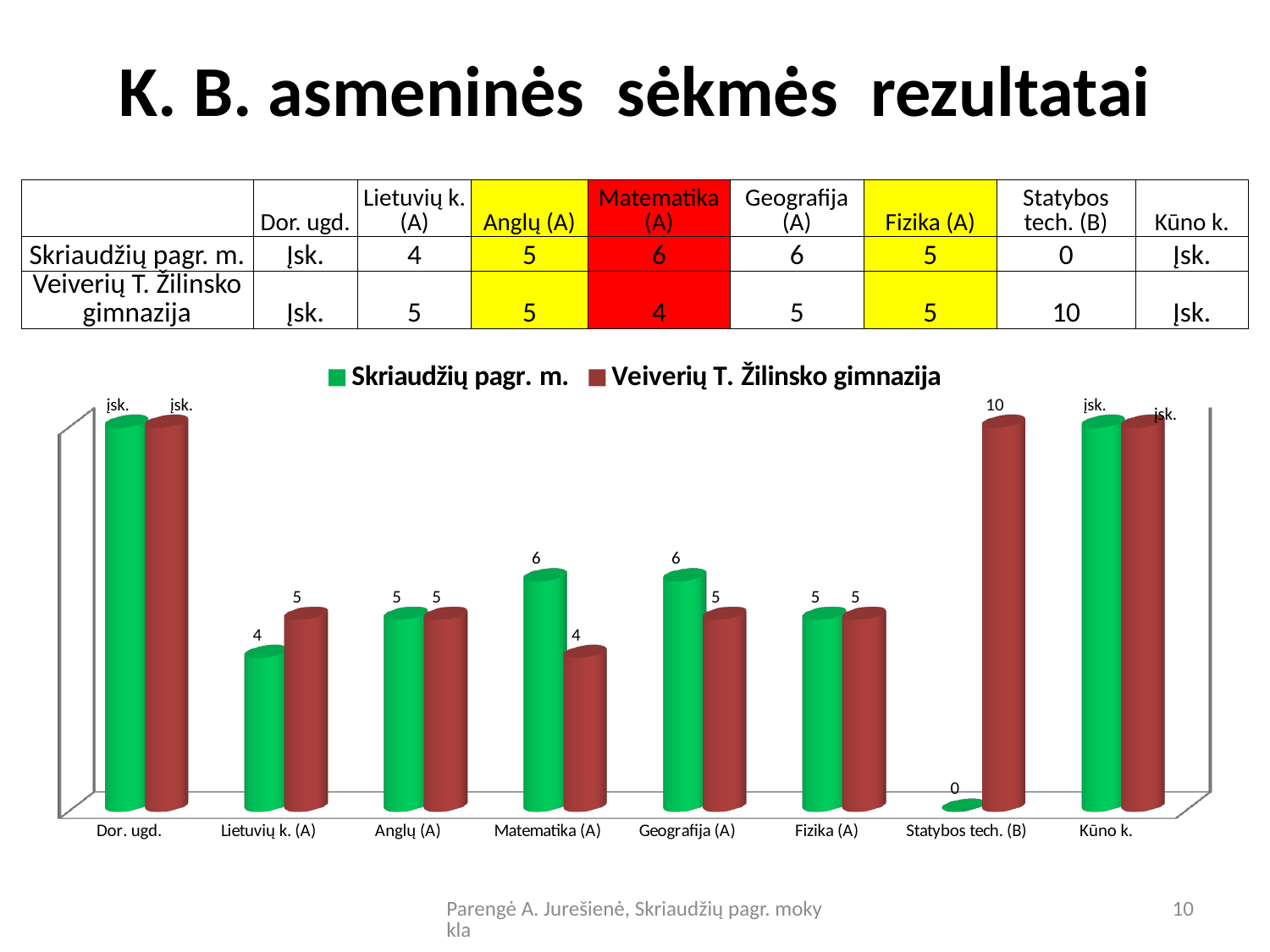
Which category has the lowest value for Skriaudžių pagr. m. among the numeric bars? Statybos tech. (B) How many series does the chart legend list? 2 How many categories are shown on the x axis of the chart? 8 What value does the chart show for Skriaudžių pagr. m. in Geografija (A)? 6 What value does the chart show for Veiverių T. Žilinsko gimnazija in Statybos tech. (B)? 10 What is the difference between the two series' values in Statybos tech. (B)? 10 What value does the chart show for Veiverių T. Žilinsko gimnazija in Matematika (A)? 4 In Geografija (A), which series has the larger value? Skriaudžių pagr. m. What value does the chart show for Skriaudžių pagr. m. in Lietuvių k. (A)? 4 Which category has the highest value for Veiverių T. Žilinsko gimnazija among the numeric bars? Statybos tech. (B) What kind of chart is shown on the slide? Bar chart What is the difference between the Skriaudžių pagr. m. and Veiverių T. Žilinsko gimnazija values in Matematika (A)? 2